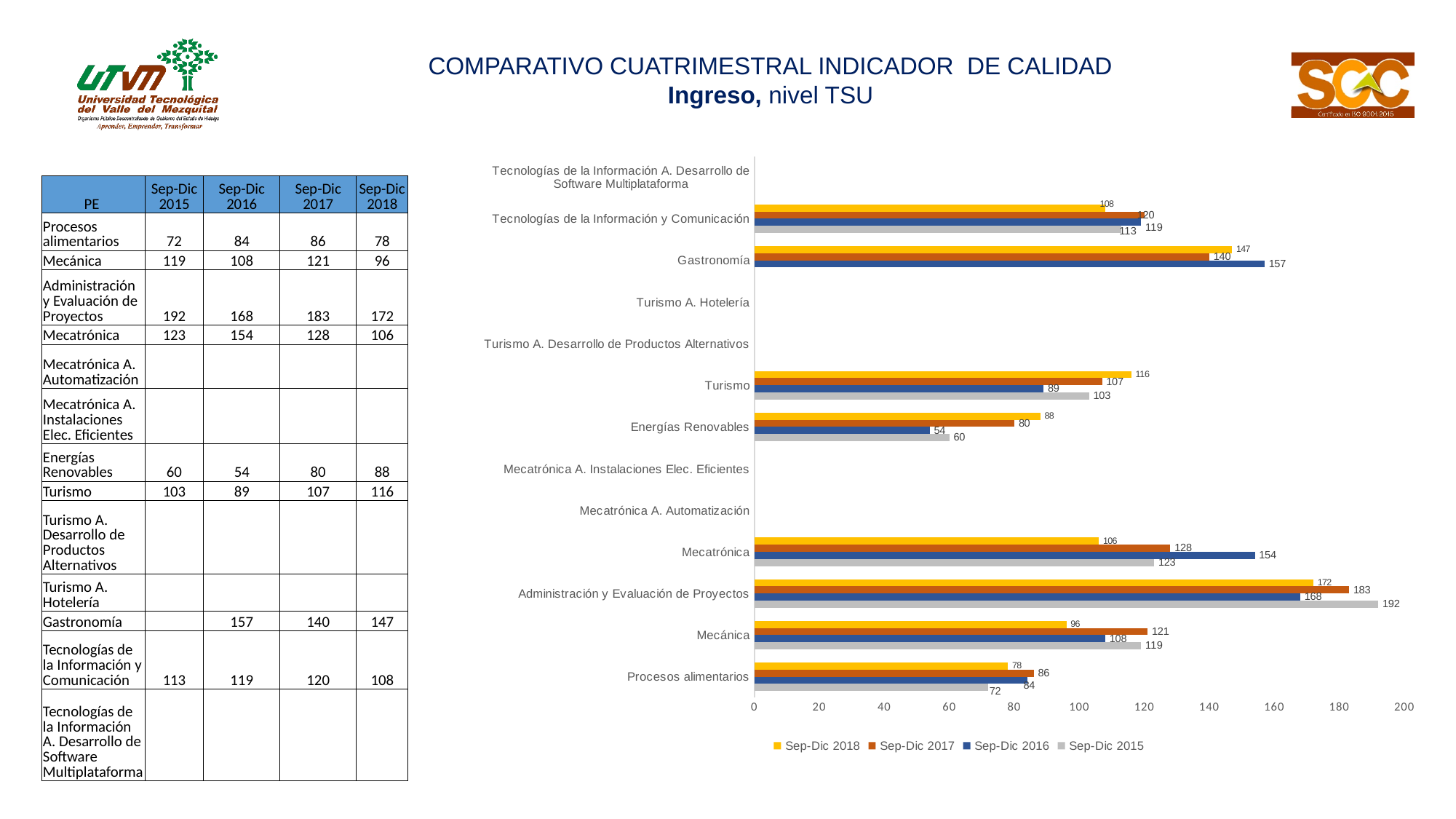
Which category has the highest Sep-Dic 2018 value? Administración y Evaluación de Proyectos Which is larger for Mecatrónica: the Sep-Dic 2016 value or the Sep-Dic 2017 value? Sep-Dic 2016 How many categories are listed on the vertical axis of the chart? 13 How many series does the chart legend list? 4 What is the difference between the Sep-Dic 2017 and Sep-Dic 2018 values for Mecánica? 25 Which series is shown in yellow in the chart legend? Sep-Dic 2018 What is the Sep-Dic 2016 value for Gastronomía? 157 What is the Sep-Dic 2018 value for Energías Renovables? 88 Is the Sep-Dic 2015 value for Turismo greater or less than 120? less Which category has the lowest Sep-Dic 2016 value? Energías Renovables What type of chart is shown on the slide? bar chart What is the Sep-Dic 2015 value for Administración y Evaluación de Proyectos? 192